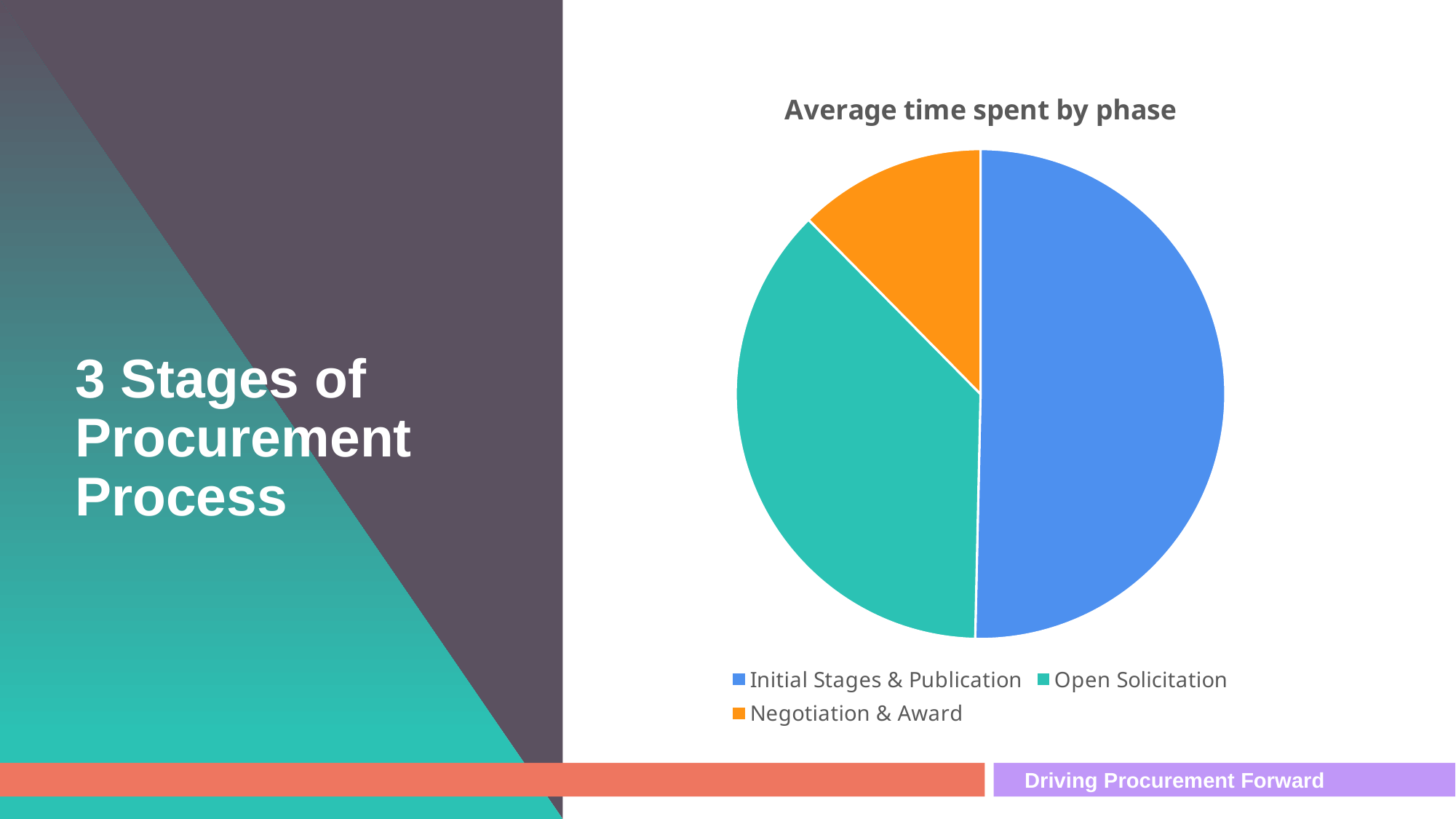
What is the title of the chart? Average time spent by phase Which phase takes up the smallest share of the pie? Negotiation & Award What kind of chart is shown on the slide? Pie chart Which slice is larger: Open Solicitation or Negotiation & Award? Open Solicitation Which phase takes up the largest share of the pie? Initial Stages & Publication Which phase is shown in teal in the pie chart? Open Solicitation How many entries does the chart legend list? 3 How many slices does the pie chart have? 3 Which colour represents Negotiation & Award in the pie chart? Orange Which slice is larger: Initial Stages & Publication or Open Solicitation? Initial Stages & Publication